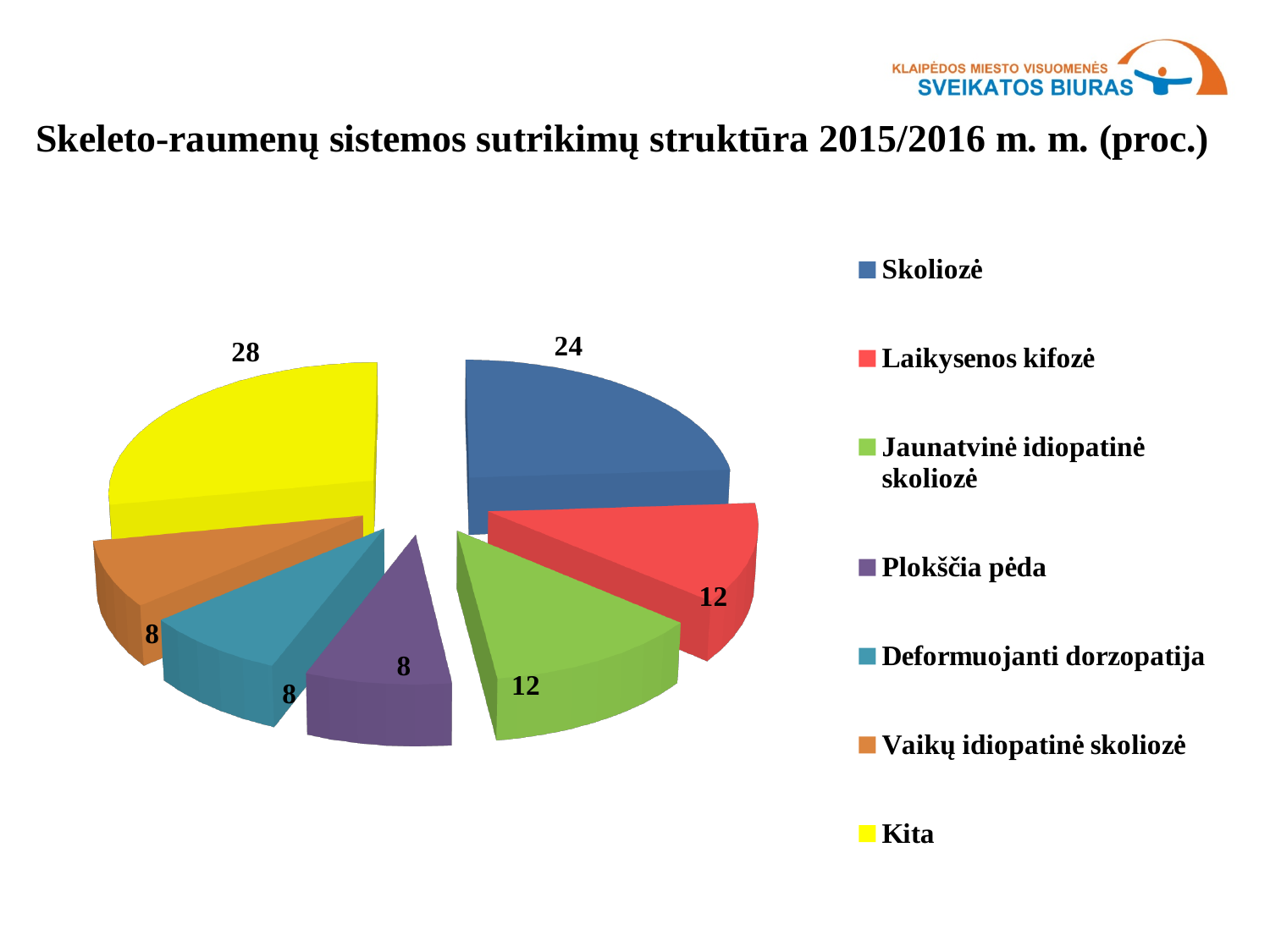
What colour is the slice for Kita? yellow Which category has the largest slice? Kita What is the value for Skoliozė? 24 What kind of chart is shown on the slide? pie chart What is the title of the chart? Skeleto-raumenų sistemos sutrikimų struktūra 2015/2016 m. m. (proc.) What is the value for Plokščia pėda? 8 How many categories does the pie chart have? 7 What is the value for Kita? 28 What is the difference between the values for Kita and Skoliozė? 4 What is the difference between the values for Laikysenos kifozė and Deformuojanti dorzopatija? 4 Which is larger, the value for Skoliozė or the value for Jaunatvinė idiopatinė skoliozė? Skoliozė What is the value for Laikysenos kifozė? 12